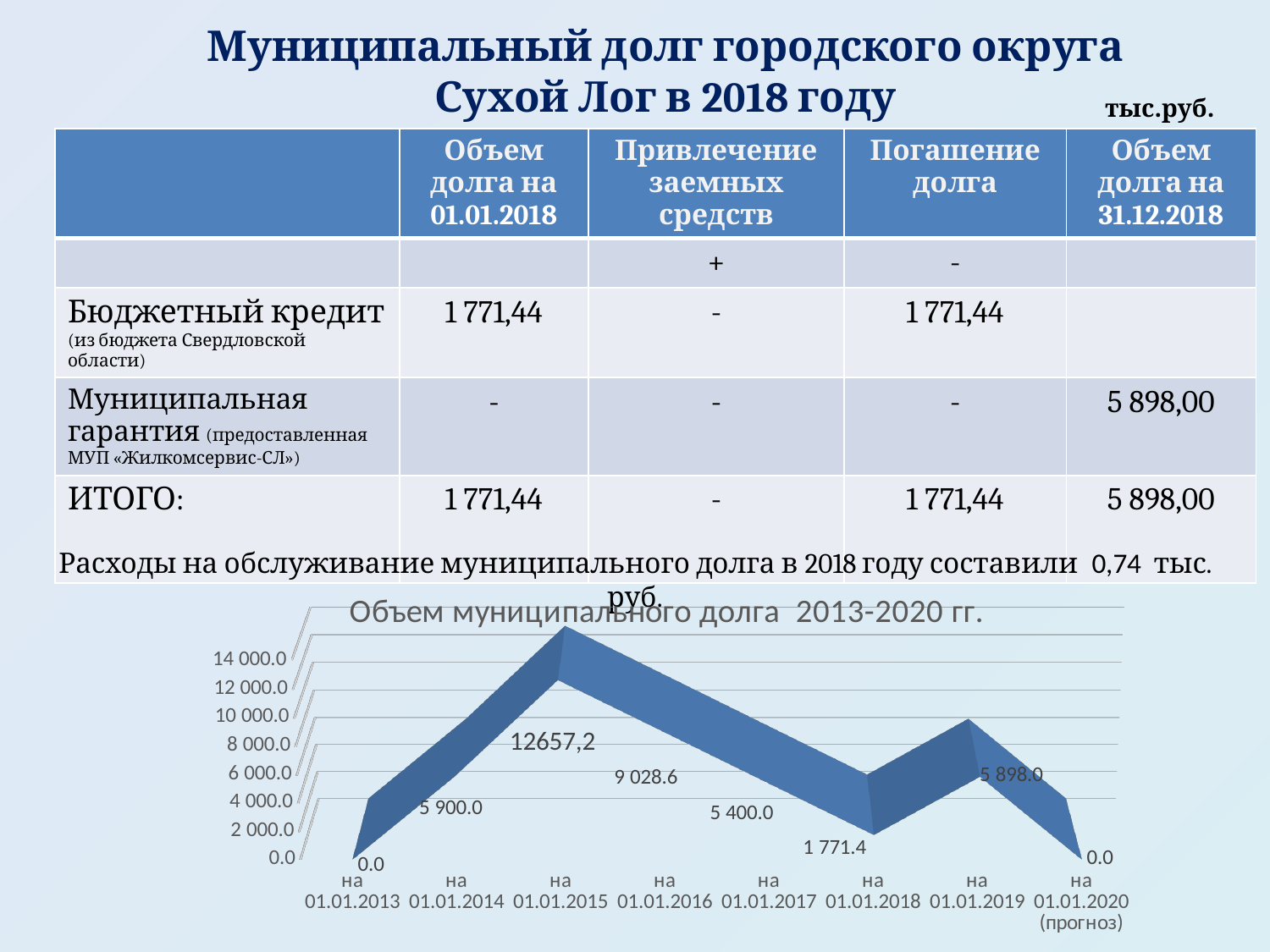
Do the values rise or fall from на 01.01.2015 to на 01.01.2018? fall What is the value for на 01.01.2016? 9 028.6 What is the title of the chart? Объем муниципального долга 2013-2020 гг. What is the value for на 01.01.2015? 12657,2 Which date has the highest value on the chart? на 01.01.2015 Which is larger, the value for на 01.01.2016 or the value for на 01.01.2017? на 01.01.2016 What is the value for на 01.01.2019? 5 898.0 What is the difference between the values for на 01.01.2017 and на 01.01.2018? 3 628.6 What is the value for на 01.01.2014? 5 900.0 How many data points are plotted on the chart? 8 What kind of chart is shown on the slide? line chart What is the value for на 01.01.2018? 1 771.4